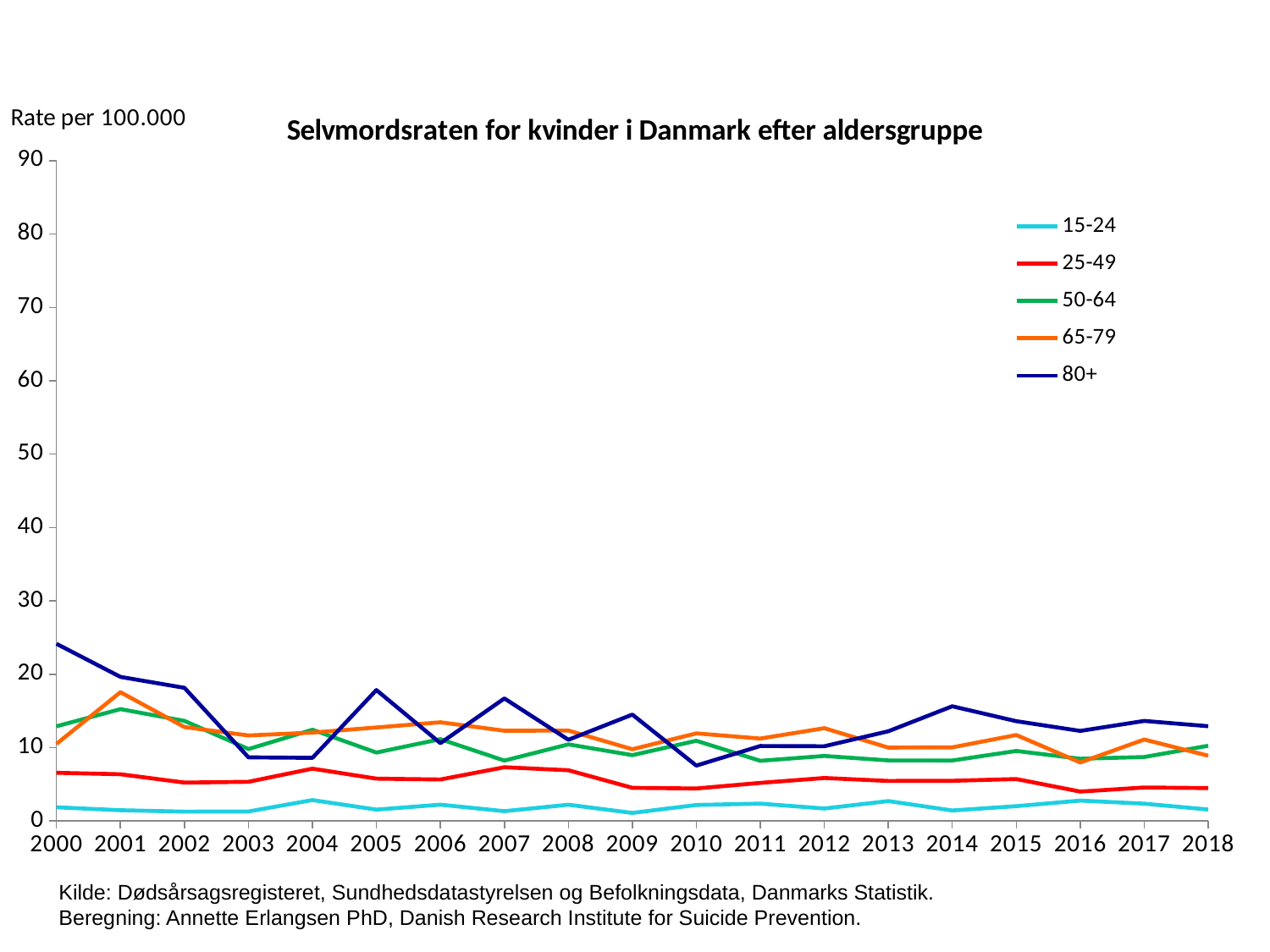
Is the value for the 15-24 group in 2004 greater or less than 10? less What unit label is shown above the y axis? Rate per 100.000 Is the value for the 65-79 group in 2001 greater or less than 10? greater Is the value for the 80+ group in 2000 greater or less than 20? greater Does the rate for the 80+ group rise or fall from 2000 to 2003? fall How many years are shown along the x axis? 19 In 2010, which is larger: the rate for 65-79 or the rate for 80+? 65-79 What type of chart is shown on the slide? line chart Which age group has the lowest rate in 2000? 15-24 What is the title of the chart? Selvmordsraten for kvinder i Danmark efter aldersgruppe Which age group has the highest rate in 2000? 80+ How many series does the legend list? 5